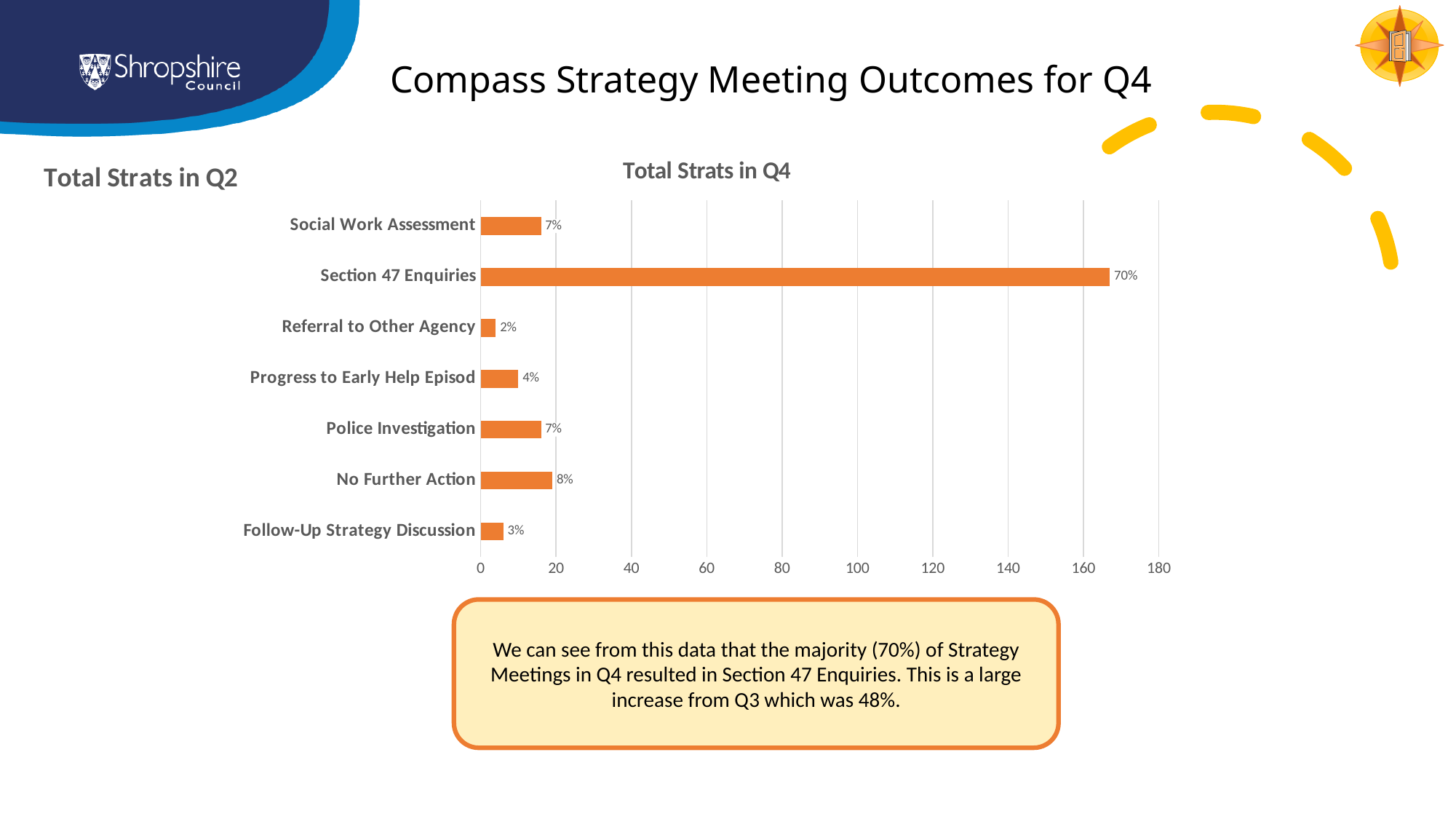
How many categories are shown in the chart? 7 What data label is shown for No Further Action? 8% What kind of chart is shown? Bar chart What data label is shown for Progress to Early Help Episod? 4% What data label is shown for Section 47 Enquiries? 70% Is the value for Section 47 Enquiries on the axis greater or less than 160? greater Which category has the highest value? Section 47 Enquiries What data label is shown for Follow-Up Strategy Discussion? 3% Which is larger, the value for No Further Action or the value for Progress to Early Help Episod? No Further Action Which category has the lowest value? Referral to Other Agency What is the title of the chart? Total Strats in Q4 What is the difference in percentage points between the labels for Section 47 Enquiries and No Further Action? 62%